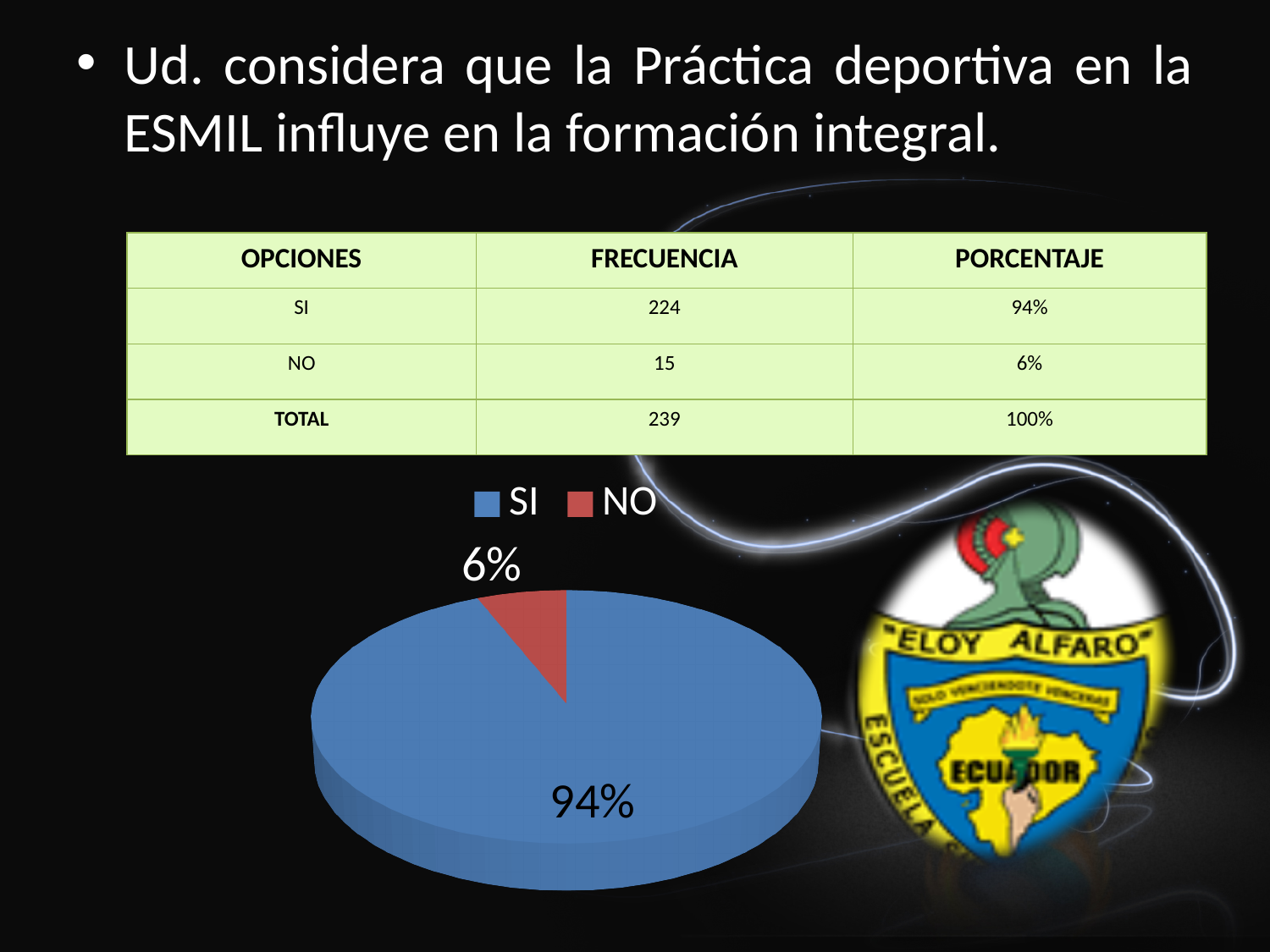
What is the difference in percentage points between the SI and NO slices? 88 How many entries does the legend of the pie chart list? 2 What colour is the NO slice in the pie chart? red Which is larger in the pie chart, SI or NO? SI What kind of chart is shown on the slide? pie chart Which slice of the pie is the largest? SI What share of the pie does the NO slice represent? 6% What share of the pie does the SI slice represent? 94% How many slices does the pie chart have? 2 Which slice of the pie is the smallest? NO What colour is the SI slice in the pie chart? blue